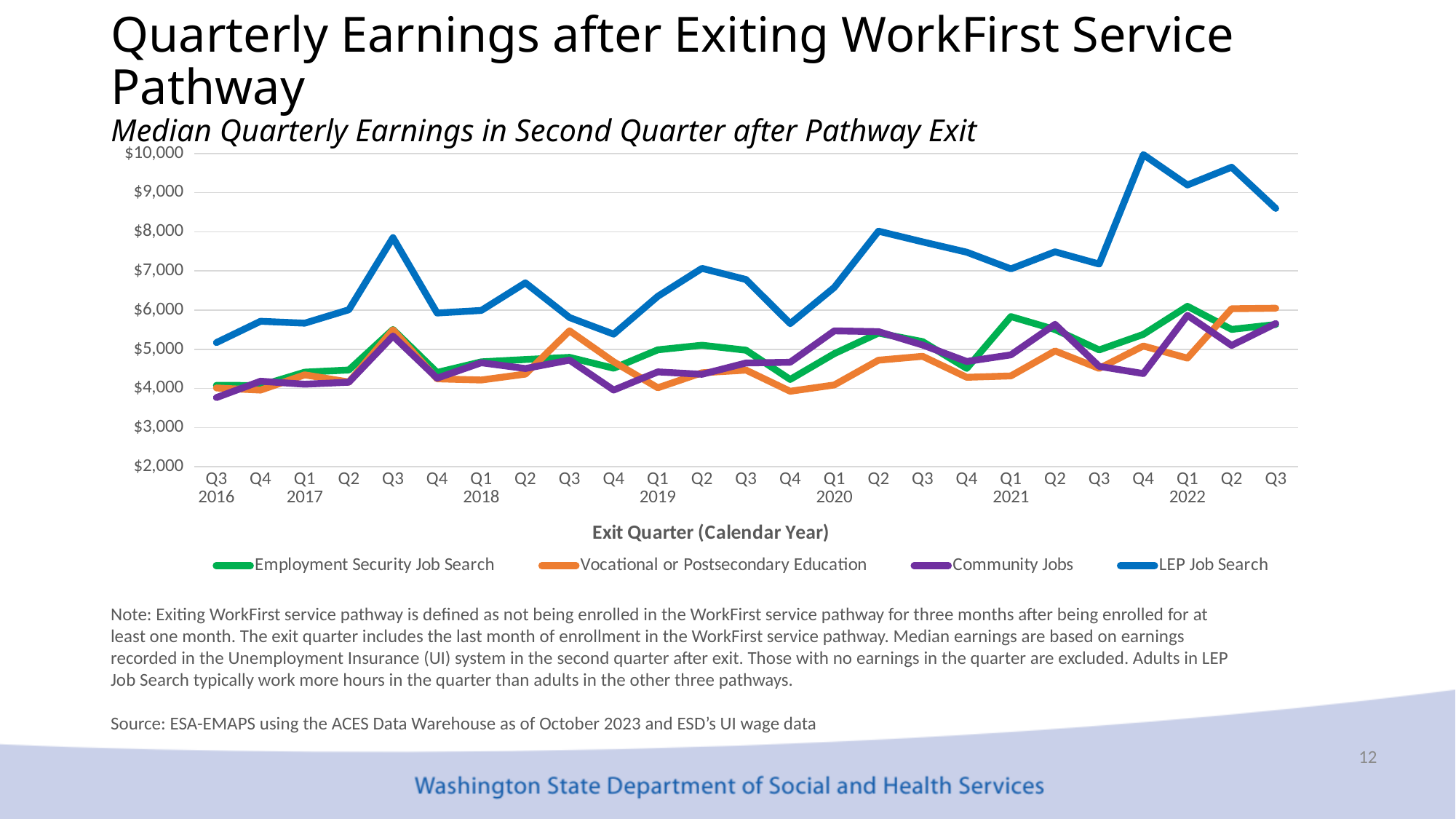
Is the value for Community Jobs in Q3 2016 greater or less than $4,000? less Which series has the lowest median quarterly earnings in Q1 2021? Vocational or Postsecondary Education How many series does the legend list? 4 In Q4 2021, which is larger: LEP Job Search or Community Jobs? LEP Job Search What is the label of the x axis? Exit Quarter (Calendar Year) Is the value for LEP Job Search in Q4 2019 greater or less than $6,000? less What kind of chart is shown on the slide? Line chart How many exit quarters are plotted along the x axis? 25 Is the value for LEP Job Search in Q3 2017 greater or less than $7,000? greater Does the LEP Job Search line generally rise or fall from Q3 2016 to Q3 2022? rise Which series has the lowest median quarterly earnings in Q3 2016? Community Jobs Which series has the highest median quarterly earnings in Q3 2022? LEP Job Search